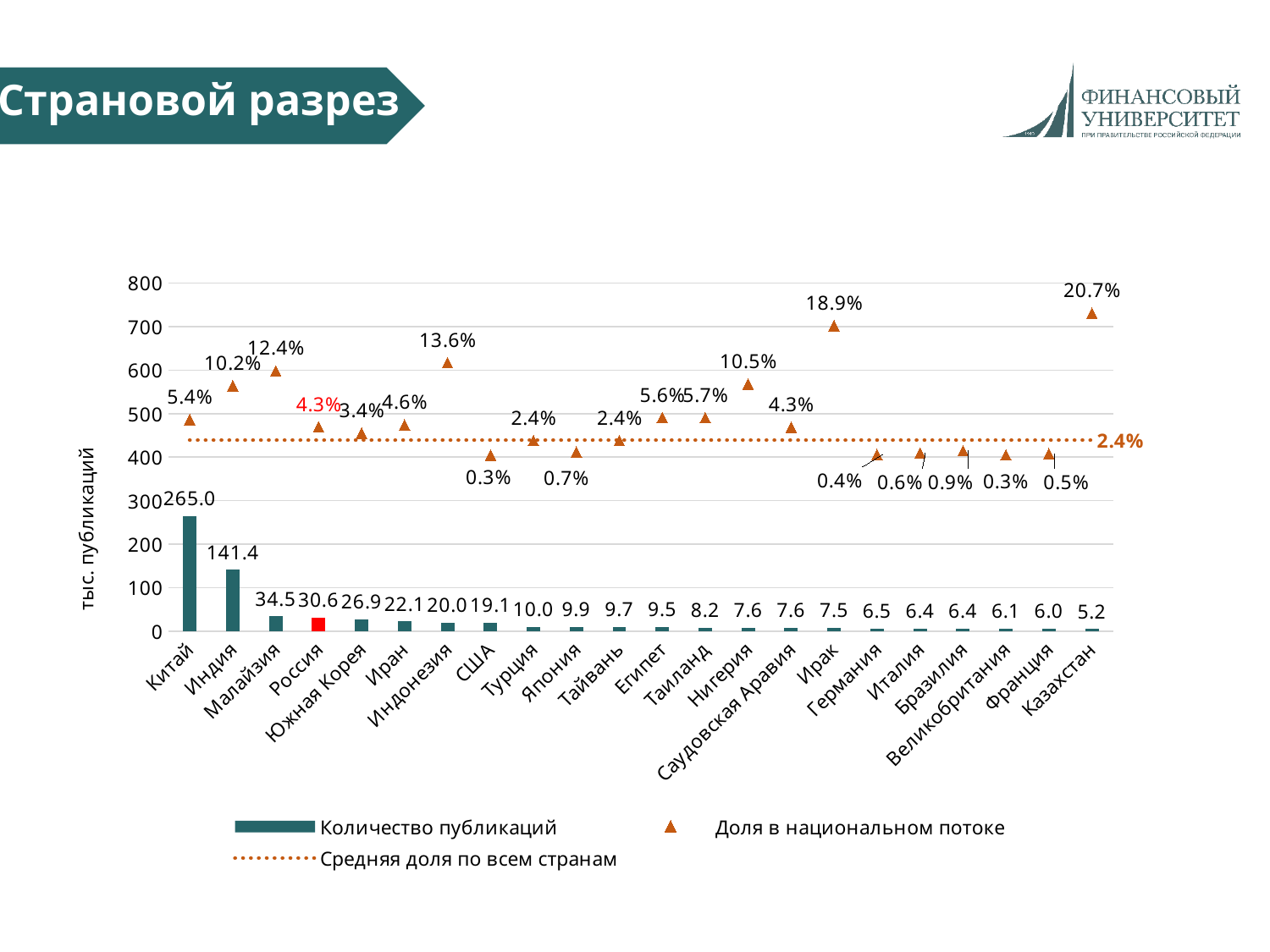
Which has a larger share in the national flow, Ирак or Нигерия? Ирак What value does the dotted line for the average share across all countries (Средняя доля по всем странам) show? 2.4% Which country has the lowest number of publications? Казахстан Do the bar values for number of publications rise or fall from left to right along the x axis? fall How many series does the legend list? 3 What is the number of publications (Количество публикаций) for Китай? 265.0 What is the difference in number of publications between Китай and Индия? 123.6 What is the number of publications for Россия? 30.6 How many countries are shown on the x axis? 22 Which country has the highest share in the national flow? Казахстан What is the share in the national flow (Доля в национальном потоке) for Казахстан? 20.7% What is the y-axis label of the chart? тыс. публикаций